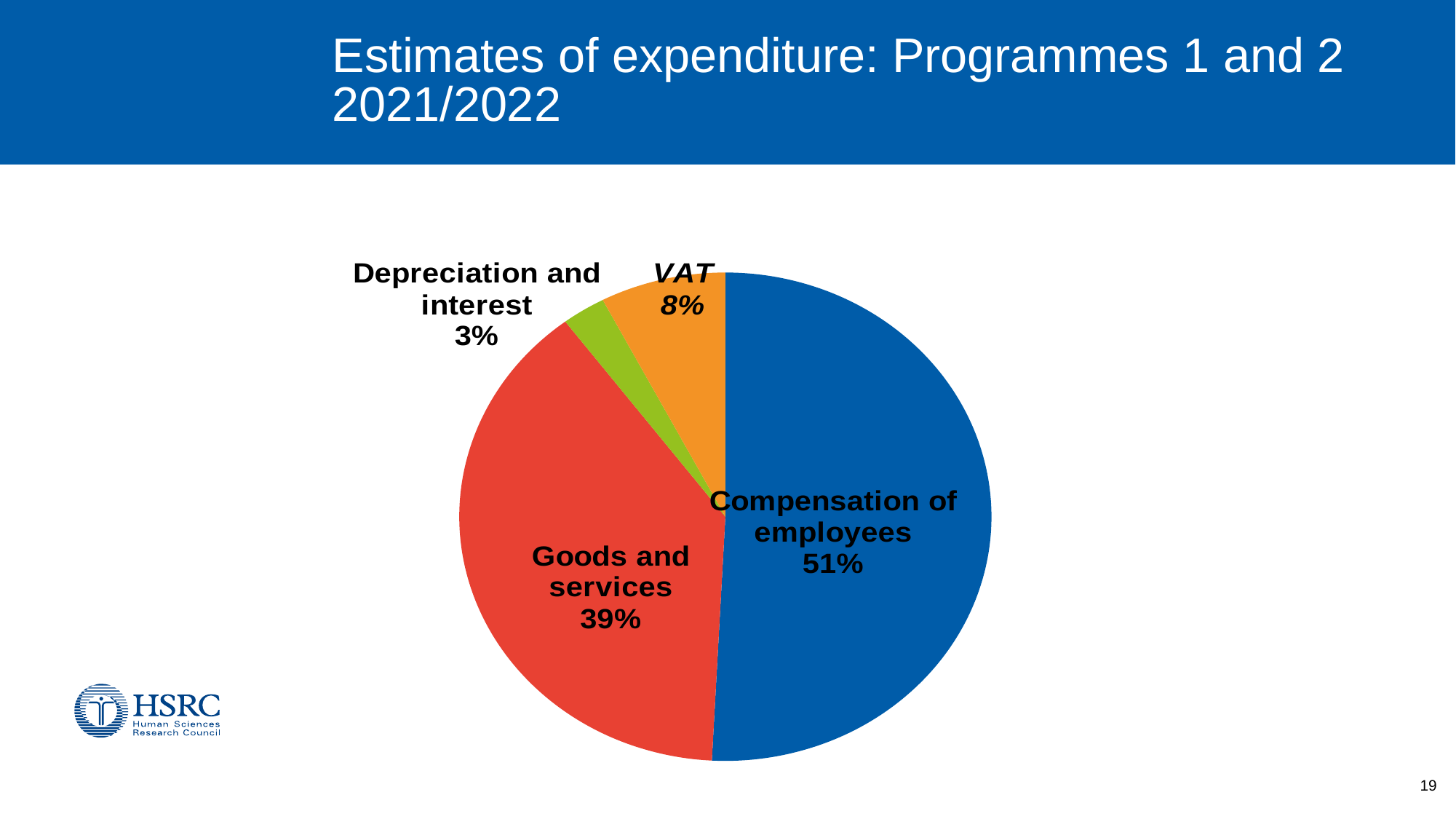
Which category has the smallest share of expenditure? Depreciation and interest What is the difference in percentage points between VAT and Depreciation and interest? 5 What share of expenditure is Goods and services? 39% What is the difference in percentage points between Compensation of employees and Goods and services? 12 What kind of chart is shown on the slide? Pie chart Which category has the largest share of expenditure? Compensation of employees What share of expenditure is Compensation of employees? 51% What share of expenditure is VAT? 8% How many categories are shown in the pie chart? 4 What share of expenditure is Depreciation and interest? 3% Which is larger, the share for VAT or the share for Depreciation and interest? VAT What colour is the Goods and services slice? Red